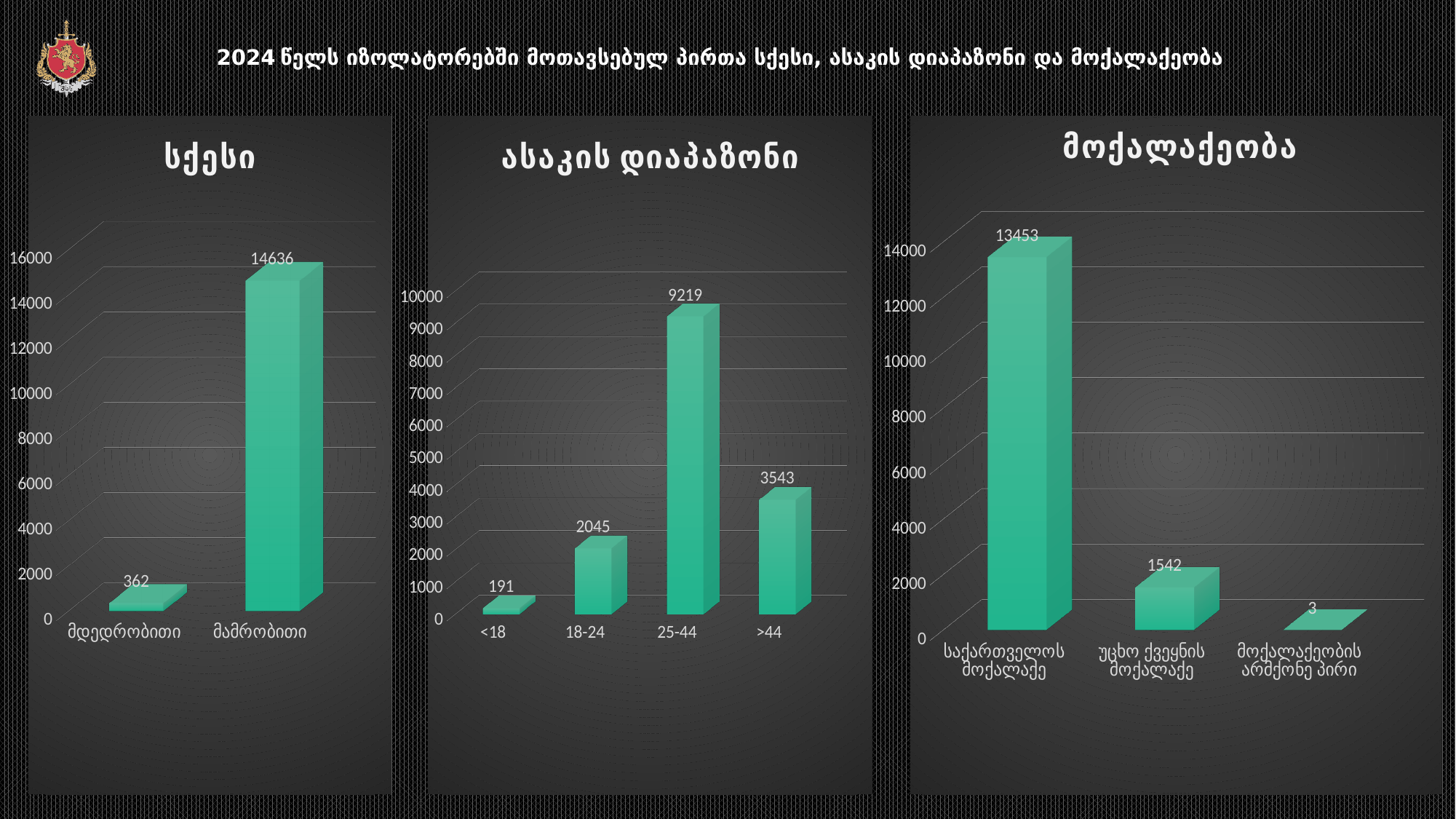
In the middle chart (ასაკის დიაპაზონი), how many age categories are shown? 4 In the right chart (მოქალაქეობა), what is the value for უცხო ქვეყნის მოქალაქე? 1542 In the right chart (მოქალაქეობა), what is the value for მოქალაქეობის არმქონე პირი? 3 In the left chart (სქესი), what is the difference between the values for მამრობითი and მდედრობითი? 14274 In the right chart (მოქალაქეობა), which category has the highest value? საქართველოს მოქალაქე In the middle chart (ასაკის დიაპაზონი), what is the value for the 25-44 category? 9219 In the middle chart (ასაკის დიაპაზონი), which is larger, the value for 18-24 or the value for >44? >44 In the left chart (სქესი), what is the value for მდედრობითი? 362 In the middle chart (ასაკის დიაპაზონი), what is the difference between the values for >44 and 18-24? 1498 What type of chart is the middle chart (ასაკის დიაპაზონი)? Bar chart In the middle chart (ასაკის დიაპაზონი), which category has the lowest value? <18 In the left chart (სქესი), what is the value for მამრობითი? 14636